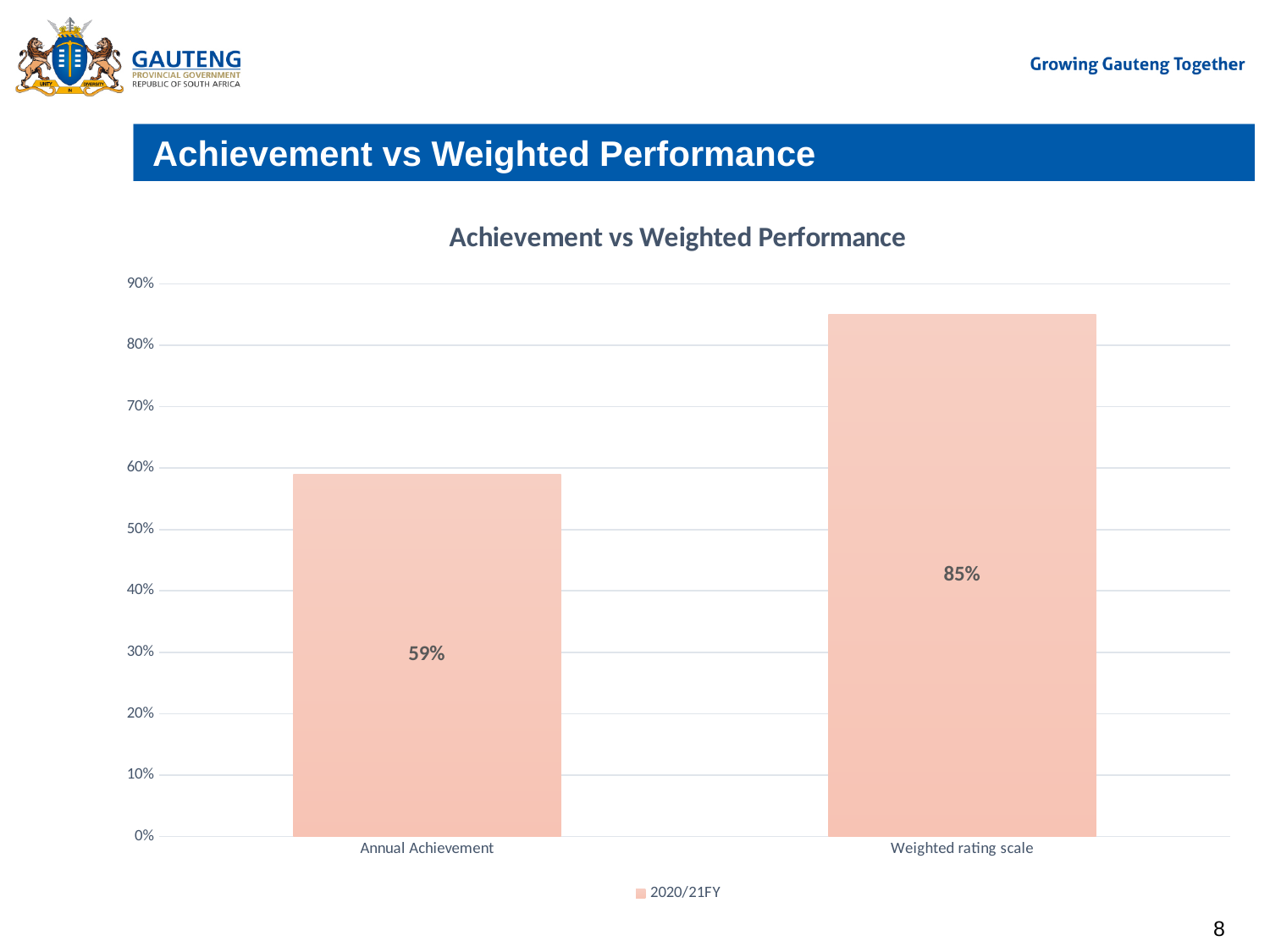
What series name is shown in the chart legend? 2020/21FY What kind of chart is shown on the slide? bar chart Which category has the lowest value? Annual Achievement Which is larger, the value for Annual Achievement or the value for Weighted rating scale? Weighted rating scale What is the value for Annual Achievement? 59% How many series does the legend list? 1 Which category has the highest value? Weighted rating scale How many categories are shown on the x axis? 2 Is the value for Annual Achievement greater or less than 60%? less What is the value for Weighted rating scale? 85% Is the value for Weighted rating scale greater or less than 80%? greater What is the difference between the Weighted rating scale value and the Annual Achievement value? 26%